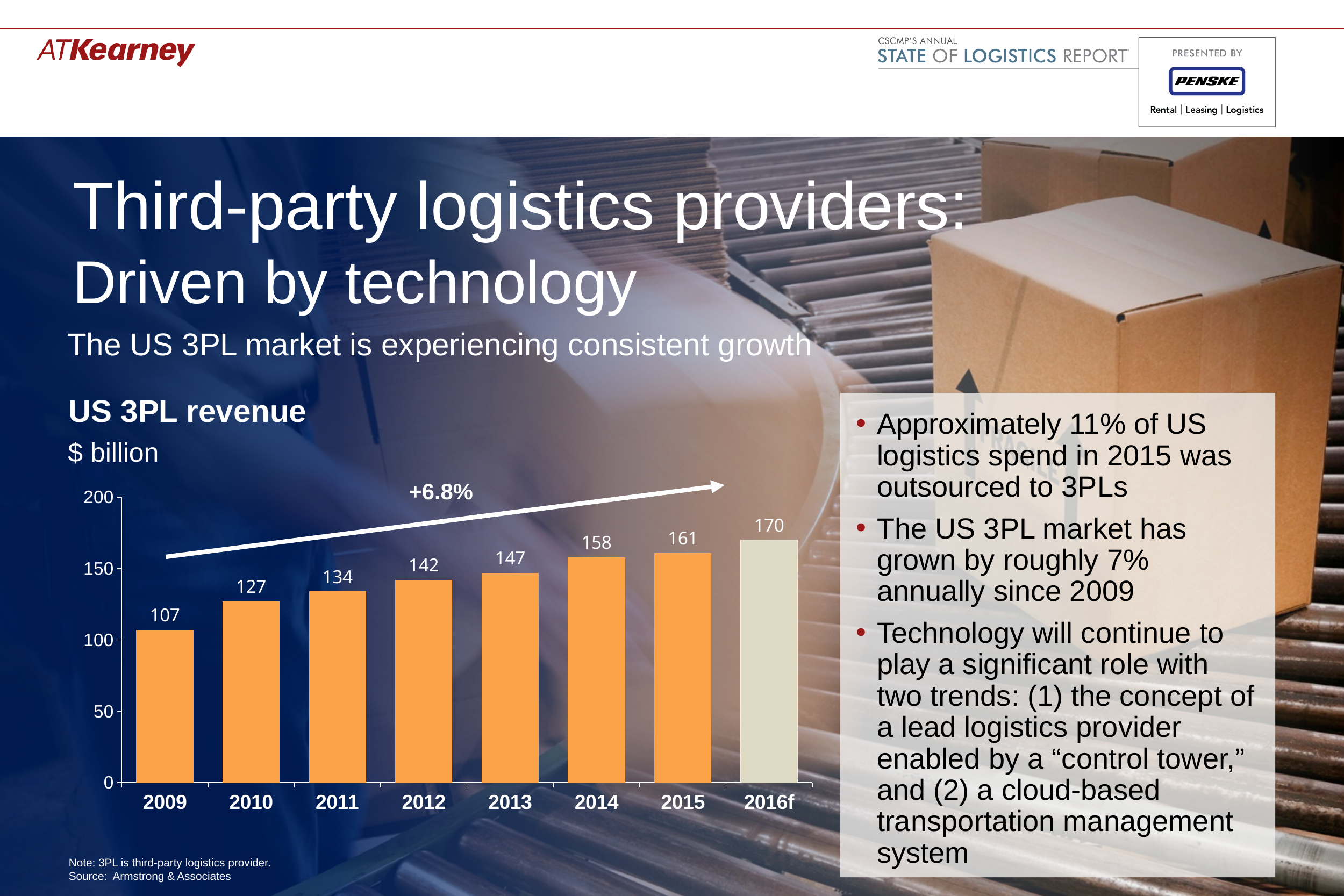
Which year has the highest US 3PL revenue? 2016f What is the forecast US 3PL revenue for 2016f? 170 Is the US 3PL revenue for 2011 greater or less than 150? less What kind of chart is used to show US 3PL revenue? bar chart How many years are shown on the x axis of the US 3PL revenue chart? 8 Which is larger, the US 3PL revenue for 2014 or for 2010? 2014 Which year has the lowest US 3PL revenue? 2009 Do US 3PL revenue values rise or fall from 2009 to 2016f? rise What is the difference in US 3PL revenue between 2015 and 2009? 54 What is the difference in US 3PL revenue between 2012 and 2011? 8 What is the US 3PL revenue for 2013? 147 What is the US 3PL revenue for 2009? 107